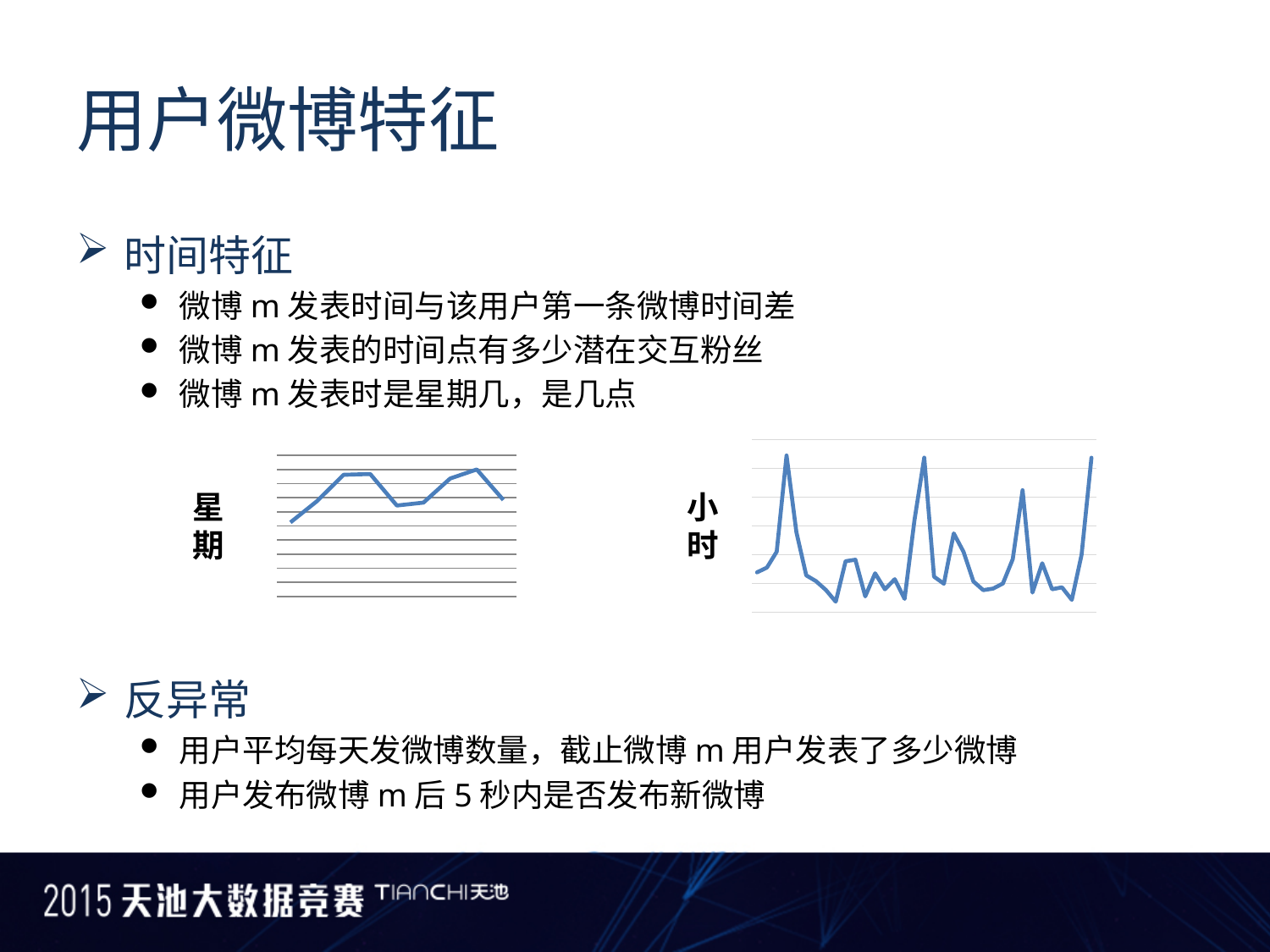
What kind of chart is the one labelled 小时 on the right? line chart What label is written to the left of the right-hand chart? 小时 How many charts are shown on the slide? 2 What kind of chart is the one labelled 星期 on the left? line chart In the chart labelled 小时, does the line rise or fall over its final few points? rise What label is written to the left of the left-hand chart? 星期 In the chart labelled 星期, is the line's last point higher or lower than its first point? higher In the chart labelled 星期, does the line rise or fall between its first point and its first peak? rise How many lines are plotted in the chart labelled 小时? 1 How many lines are plotted in the chart labelled 星期? 1